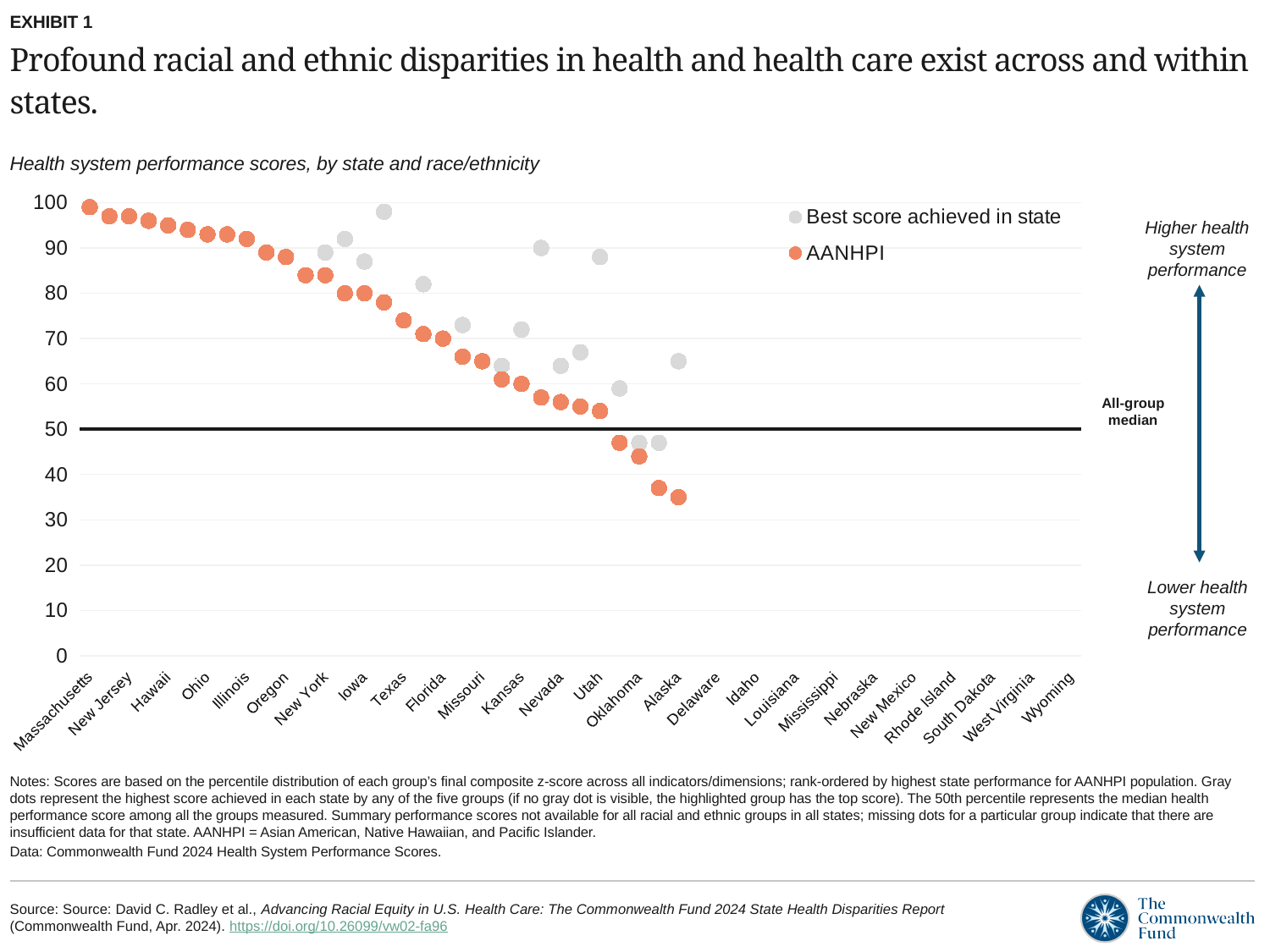
Is the AANHPI score for Oklahoma greater or less than 50? less What value does the horizontal 'All-group median' line sit at? 50 Which labeled state has the highest AANHPI score? Massachusetts What kind of chart is shown on the slide? Dot (scatter) chart Is the AANHPI score for Alaska greater or less than 40? less Which has a higher AANHPI score, Texas or Utah? Texas Which series is shown with orange dots? AANHPI Do the AANHPI scores rise or fall moving from left to right along the x axis? fall Which labeled state has the lowest AANHPI score? Alaska Is the AANHPI score for Iowa greater or less than 70? greater How many series does the legend list? 2